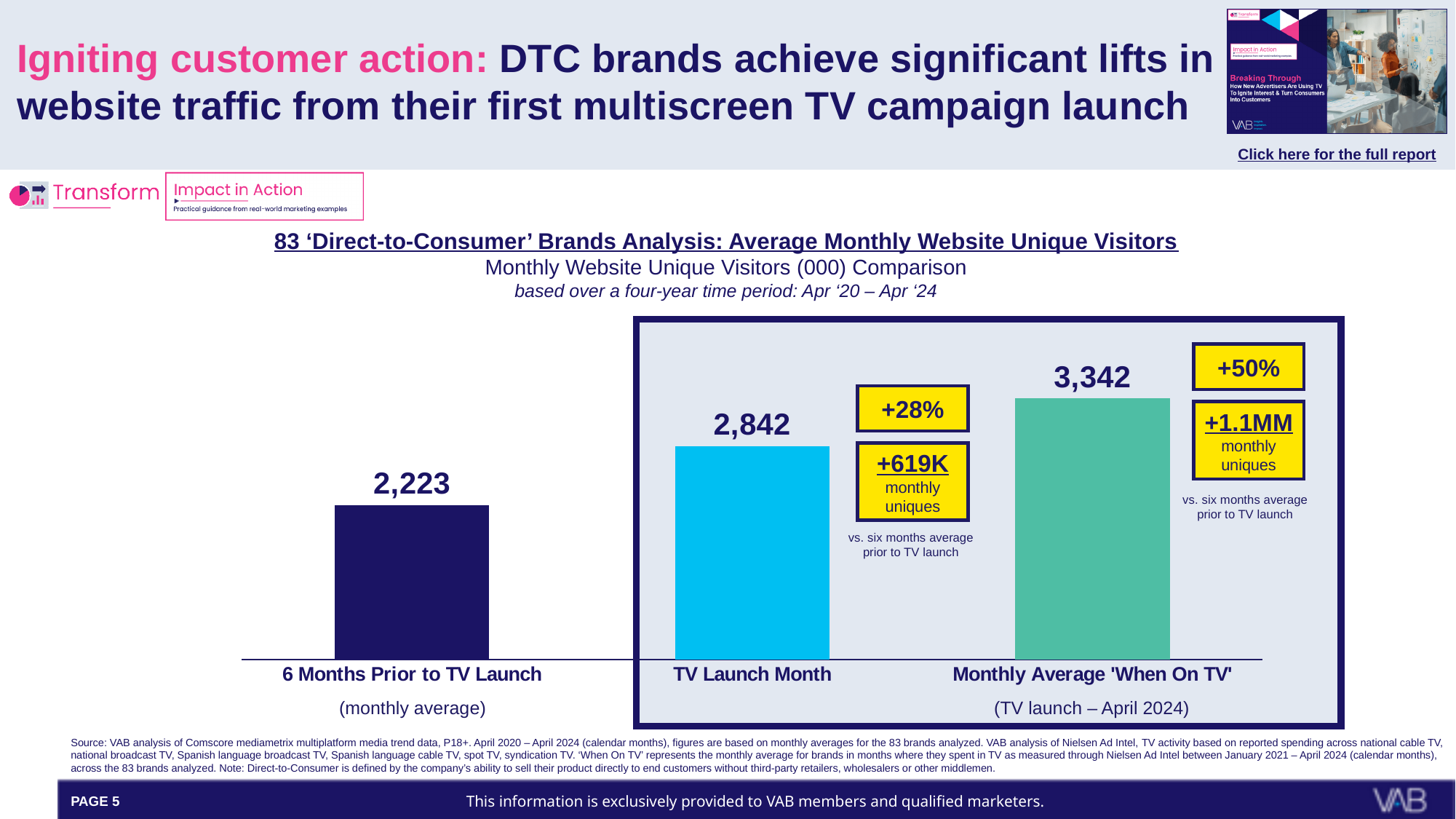
Which category has the lowest value in the chart? 6 Months Prior to TV Launch What is the value shown for 'Monthly Average "When On TV"'? 3,342 What percentage lift does the callout show for 'Monthly Average "When On TV"' versus the six months average prior to TV launch? +50% What is the difference between the 'Monthly Average "When On TV"' value and the '6 Months Prior to TV Launch' value? 1,119 What type of chart is shown on the slide? Bar chart What is the difference between the 'TV Launch Month' value and the '6 Months Prior to TV Launch' value? 619 Do the values rise or fall from left to right across the chart? Rise What is the value shown for 'TV Launch Month'? 2,842 How many bars are plotted in the chart? 3 Which category has the highest value in the chart? Monthly Average 'When On TV' What is the average monthly website unique visitors (000) value for '6 Months Prior to TV Launch'? 2,223 Which is larger, the value for 'TV Launch Month' or the value for '6 Months Prior to TV Launch'? TV Launch Month